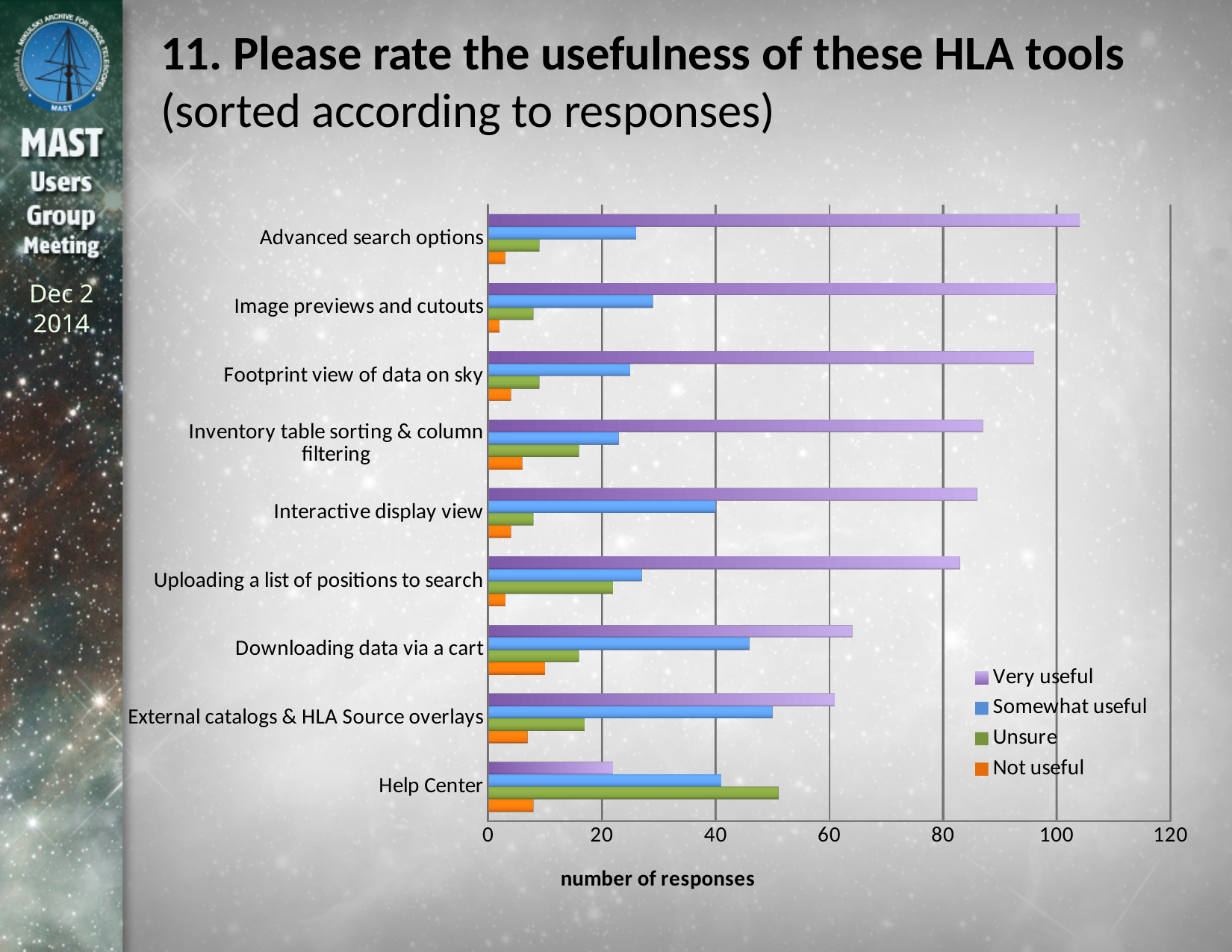
Which tool has the highest number of 'Unsure' responses? Help Center Which tool has the lowest number of 'Very useful' responses? Help Center Is the 'Somewhat useful' value for Downloading data via a cart greater or less than 40? greater What is the title of the horizontal axis? number of responses How many HLA tools (categories) are plotted on the chart? 9 How many series does the legend list? 4 For Help Center, which is larger: the 'Unsure' value or the 'Very useful' value? Unsure Is the 'Very useful' value for Help Center greater or less than 40? less Which tool has the highest number of 'Very useful' responses? Advanced search options Which has more 'Somewhat useful' responses: Interactive display view or Uploading a list of positions to search? Interactive display view Is the 'Very useful' value for Advanced search options greater or less than 100? greater What kind of chart is shown on the slide? bar chart